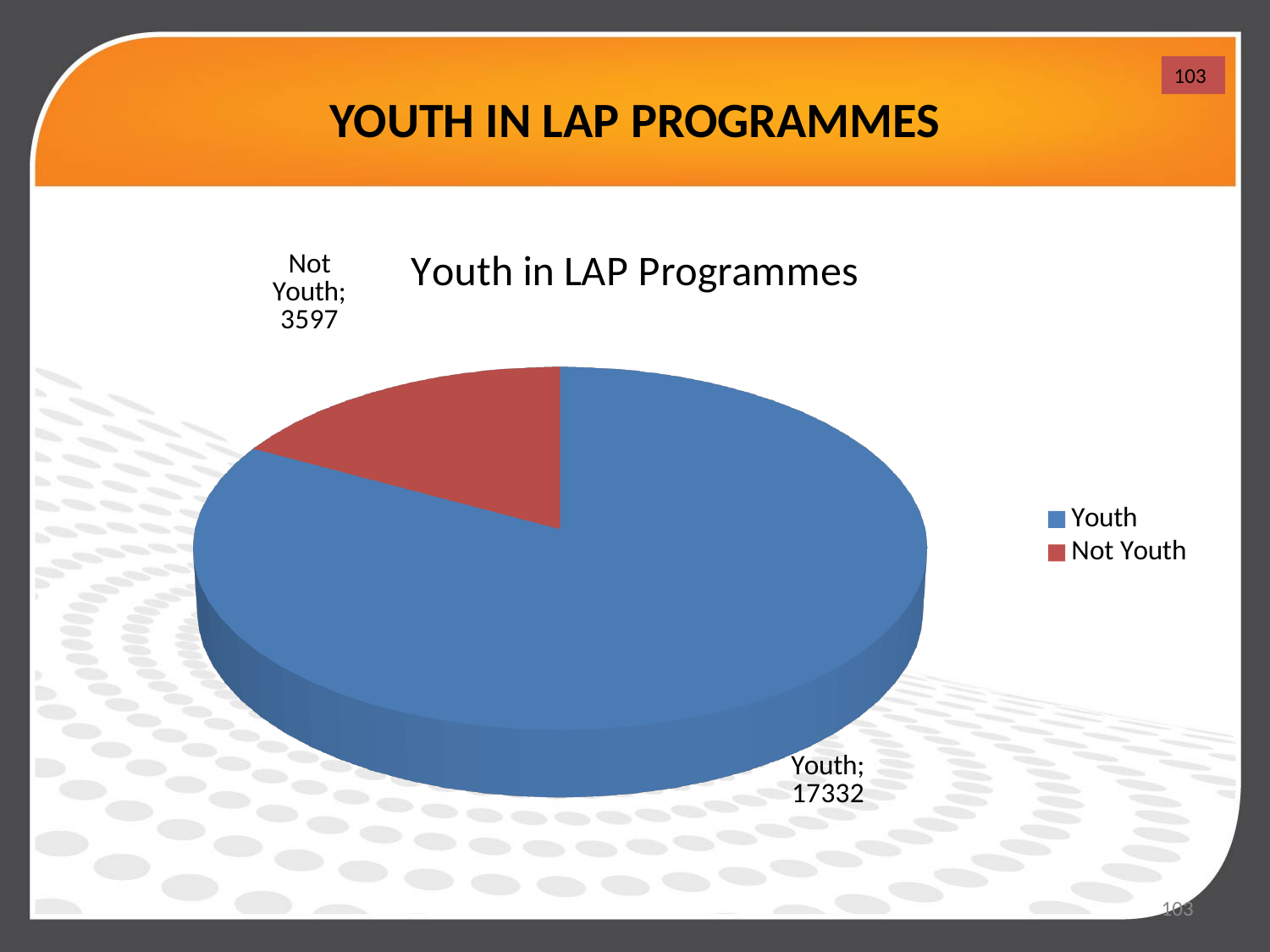
What kind of chart is shown on the slide? Pie chart How many slices does the pie chart have? 2 What colour is the Not Youth slice? Red Which is larger, the value for Youth or the value for Not Youth? Youth What is the title of the chart? Youth in LAP Programmes What is the difference between the Youth and Not Youth values? 13735 Which category has the largest slice of the pie? Youth What is the value for Youth in the pie chart? 17332 What is the value for Not Youth in the pie chart? 3597 What is the total of the two values in the pie chart? 20929 How many entries does the legend list? 2 Which category has the smallest slice of the pie? Not Youth